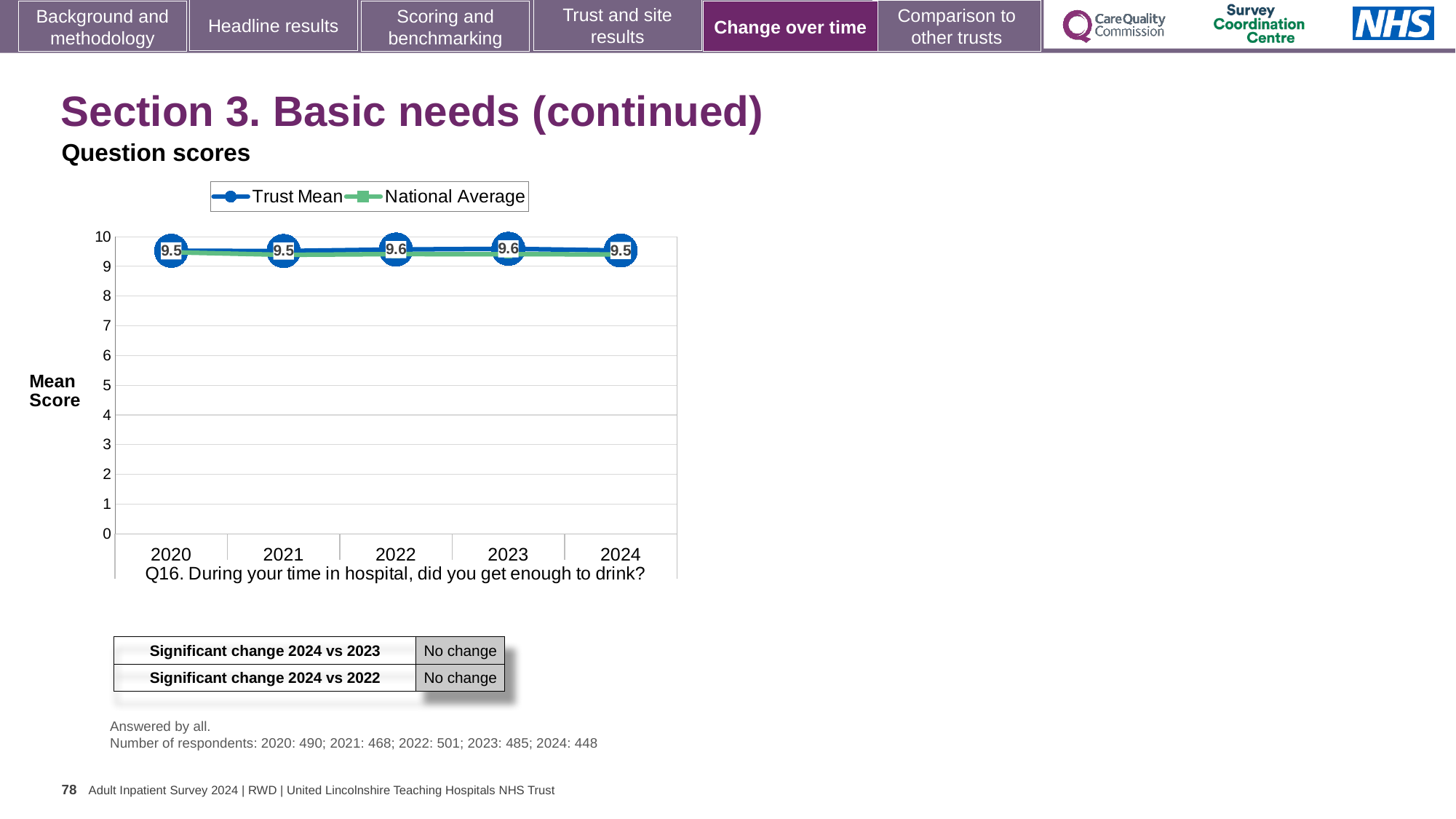
What is the Trust Mean score for 2024? 9.5 Is the National Average value for 2021 greater or less than 9? greater What is the Trust Mean score for 2022? 9.6 What is the Trust Mean score for 2020? 9.5 Does the Trust Mean rise or fall between 2023 and 2024? fall How many years are plotted on the x axis? 5 What kind of chart is shown? line chart How many series does the legend list? 2 What is the Trust Mean score for 2023? 9.6 What is the difference between the Trust Mean score for 2022 and the score for 2020? 0.1 What question is the chart about, as shown on the x axis title? Q16. During your time in hospital, did you get enough to drink? Is the Trust Mean score for 2022 larger or smaller than the score for 2024? larger